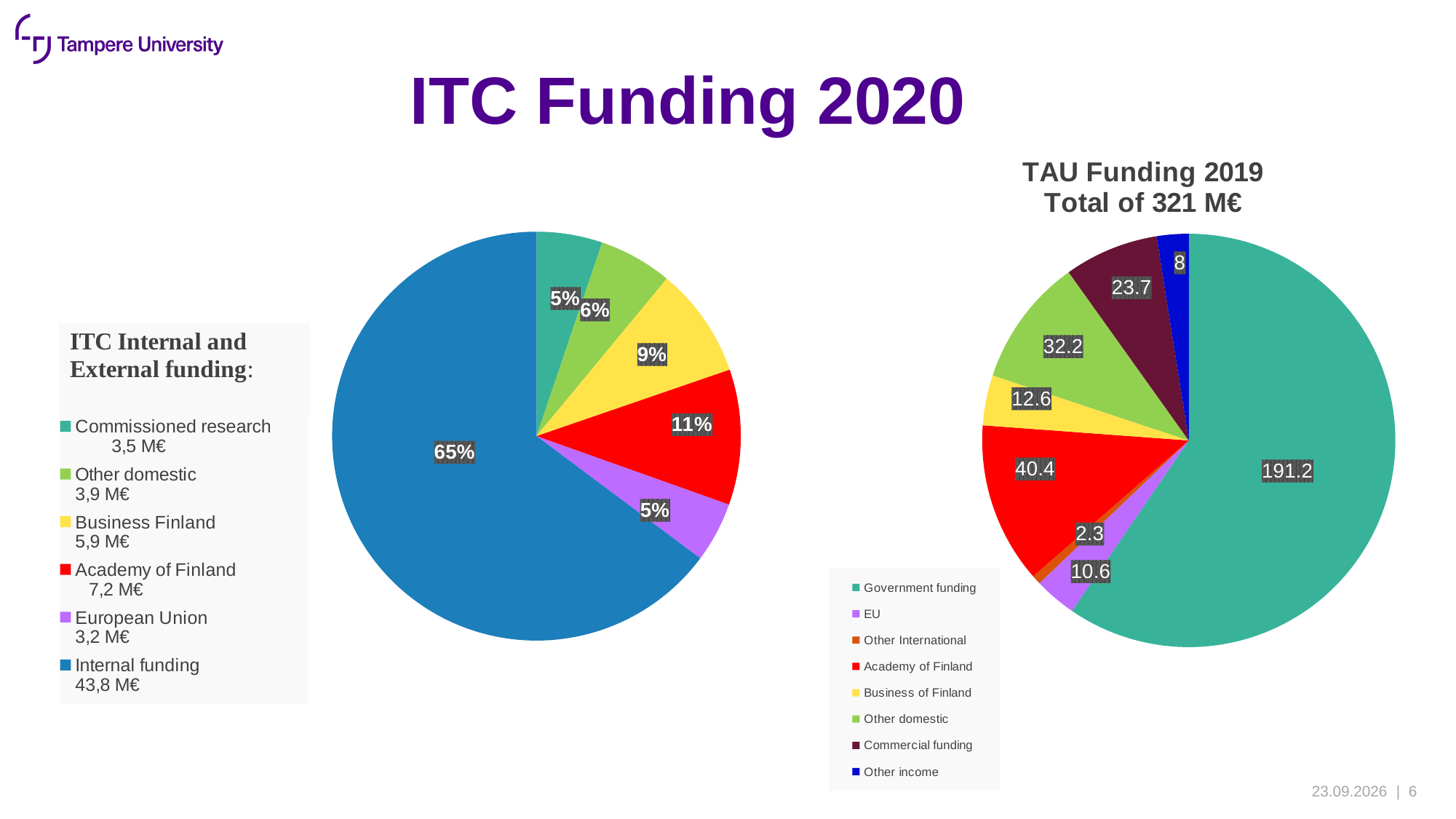
In the left pie chart (ITC Internal and External funding), what percentage share does Academy of Finland have? 11% In the TAU Funding 2019 chart, what is the value for Government funding? 191.2 In the TAU Funding 2019 chart, what is the value for Commercial funding? 23.7 What type of chart is the TAU Funding 2019 chart? Pie chart In the TAU Funding 2019 chart, which is larger, EU or Other income? EU In the left pie chart (ITC Internal and External funding), what percentage share does Business Finland have? 9% In the TAU Funding 2019 chart, which category has the smallest value? Other International In the TAU Funding 2019 chart, what is the value for Academy of Finland? 40.4 In the left pie chart (ITC Internal and External funding), how many categories does the legend list? 6 In the TAU Funding 2019 chart, what is the difference between Other domestic and Business of Finland? 19.6 In the left pie chart (ITC Internal and External funding), what percentage share does Internal funding have? 65% In the left pie chart (ITC Internal and External funding), which category has the largest share? Internal funding